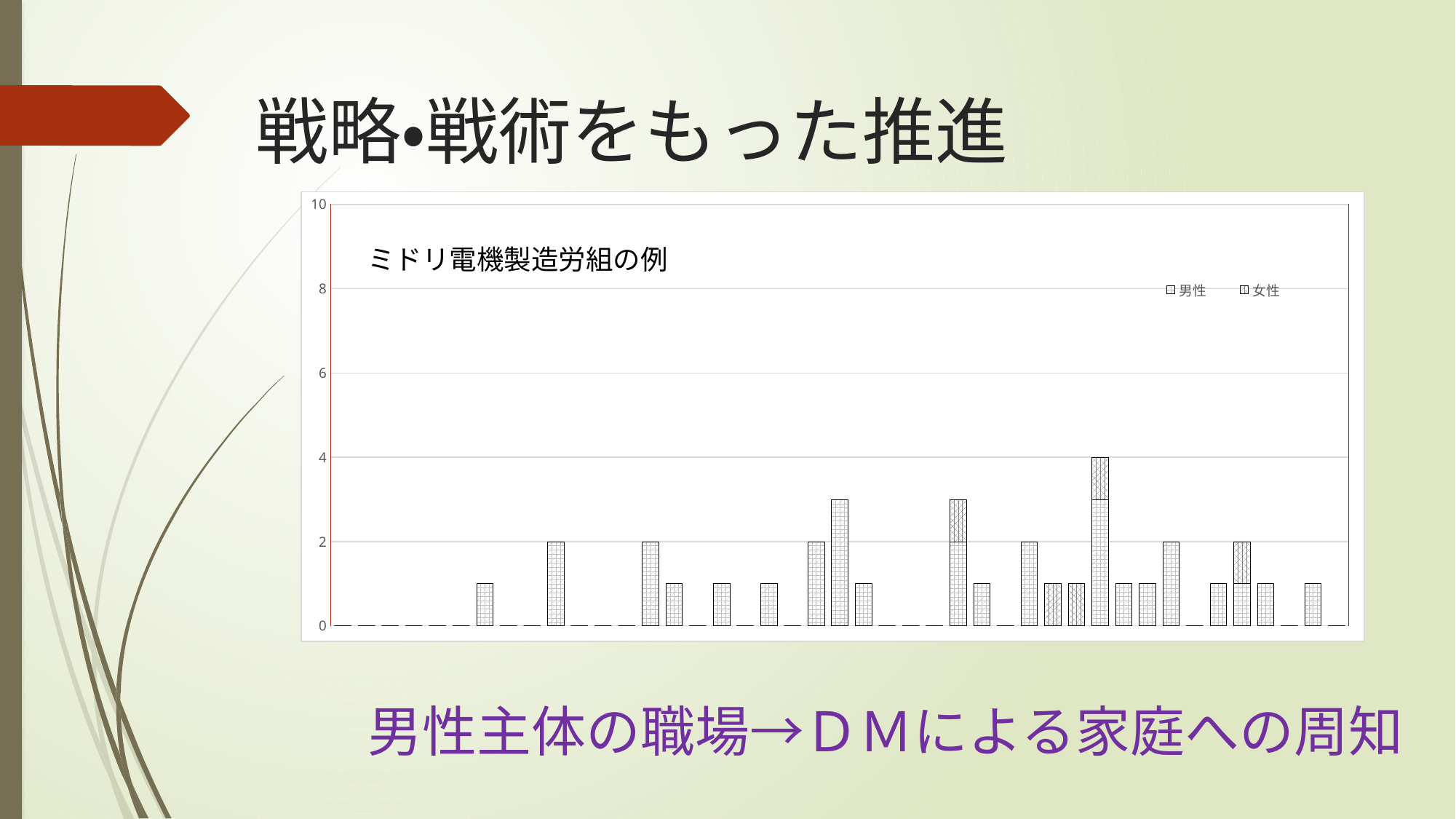
What is the highest value reached by the tallest stacked bar in the chart? 4 Is the tallest bar in the chart greater or less than 2? greater What is the title shown inside the chart? ミドリ電機製造労組の例 How many series does the chart's legend list? 2 Is the tallest bar in the chart greater or less than 6? less What are the two series named in the chart's legend? 男性, 女性 Does any bar in the chart reach a value greater than 8? No What kind of chart is shown on the slide? bar chart